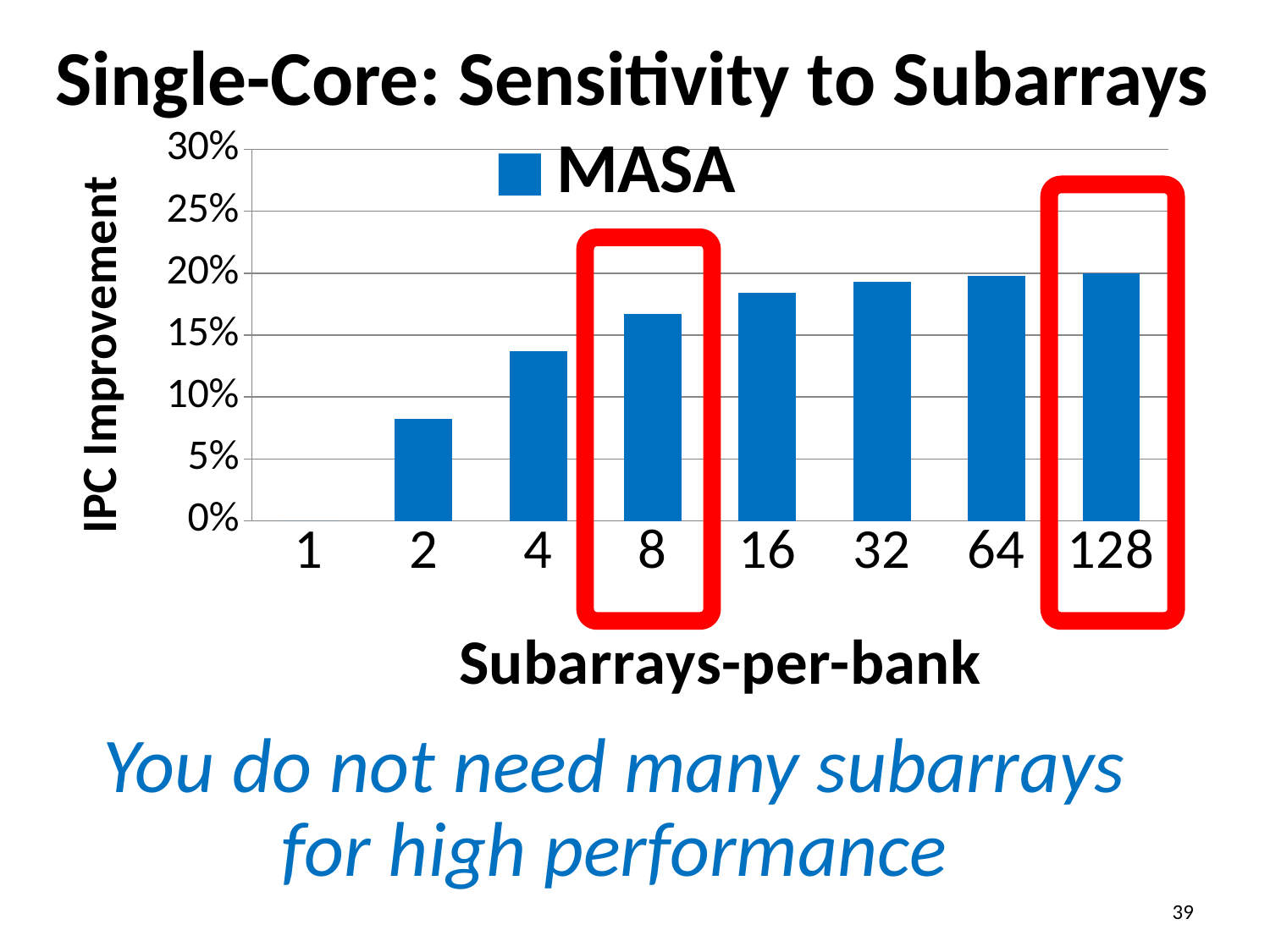
Which subarrays-per-bank value has the lowest IPC improvement? 1 What kind of chart is shown on the slide? bar chart What is the label of the y axis? IPC Improvement What is the name of the series shown in the legend? MASA Do the IPC improvement values rise or fall as subarrays-per-bank increases along the x axis? rise Is the IPC improvement for 2 subarrays-per-bank greater or less than 10%? less Is the IPC improvement for 4 subarrays-per-bank greater or less than 10%? greater How many series does the legend list? 1 Is the IPC improvement for 8 subarrays-per-bank greater or less than 15%? greater Which has a larger IPC improvement, 2 subarrays-per-bank or 8 subarrays-per-bank? 8 How many subarrays-per-bank categories are shown on the x axis? 8